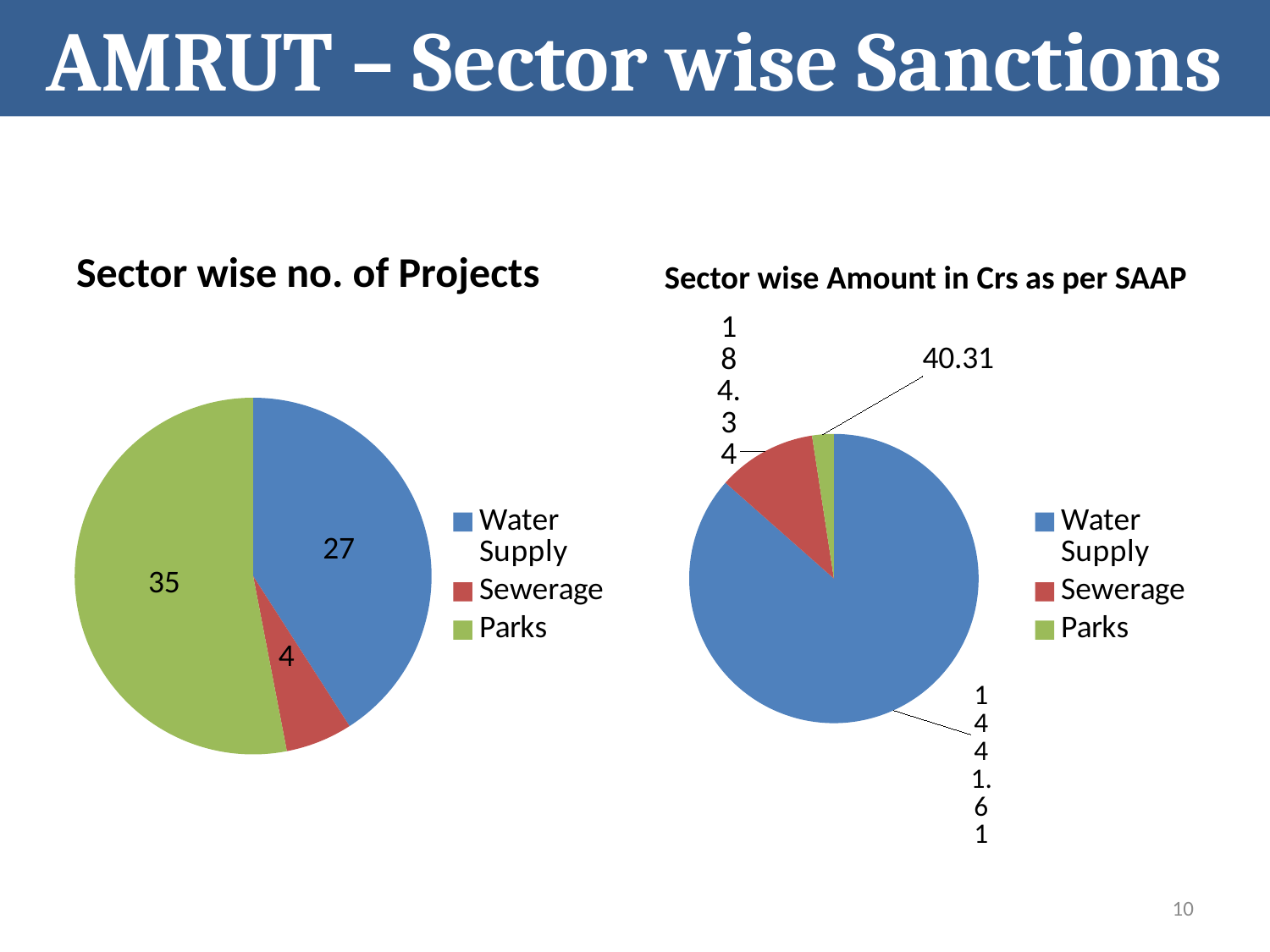
In the 'Sector wise no. of Projects' chart, how many projects are in Parks? 35 In the 'Sector wise no. of Projects' chart, how many projects are in Water Supply? 27 In the 'Sector wise no. of Projects' chart, what is the total number of projects across all sectors? 66 In the 'Sector wise Amount in Crs as per SAAP' chart, is the amount for Sewerage larger or smaller than the amount for Parks? larger In the 'Sector wise Amount in Crs as per SAAP' chart, what is the amount for Parks? 40.31 In the 'Sector wise Amount in Crs as per SAAP' chart, what is the amount for Sewerage? 184.34 In the 'Sector wise Amount in Crs as per SAAP' chart, which sector has the largest amount? Water Supply In the 'Sector wise no. of Projects' chart, what is the difference between the number of Parks projects and Water Supply projects? 8 In the 'Sector wise no. of Projects' chart, which sector has the most projects? Parks In the 'Sector wise Amount in Crs as per SAAP' chart, what is the amount for Water Supply? 1441.61 In the 'Sector wise no. of Projects' chart, which sector has the fewest projects? Sewerage What type of chart is used on the left side of the slide for 'Sector wise no. of Projects'? pie chart